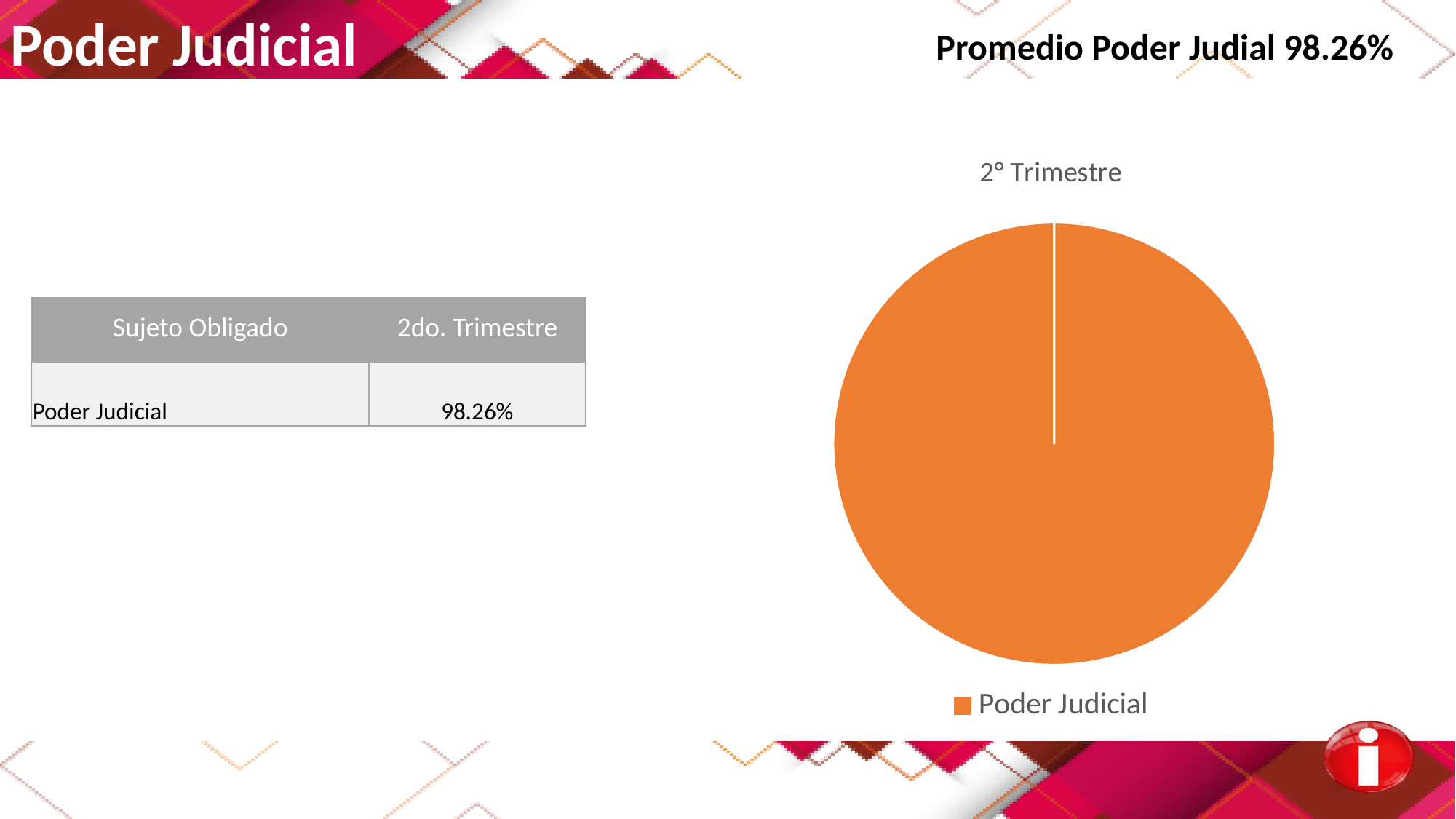
How many slices does the pie chart have? 1 What is the name of the only category in the pie chart's legend? Poder Judicial Is the value for Poder Judicial greater or less than 90%? greater What kind of chart is shown on the slide? pie chart What is the title of the pie chart? 2° Trimestre What value is shown for Poder Judicial for the 2do. Trimestre? 98.26% How many entries does the legend of the pie chart list? 1 What share of the pie does the Poder Judicial slice occupy? the whole pie